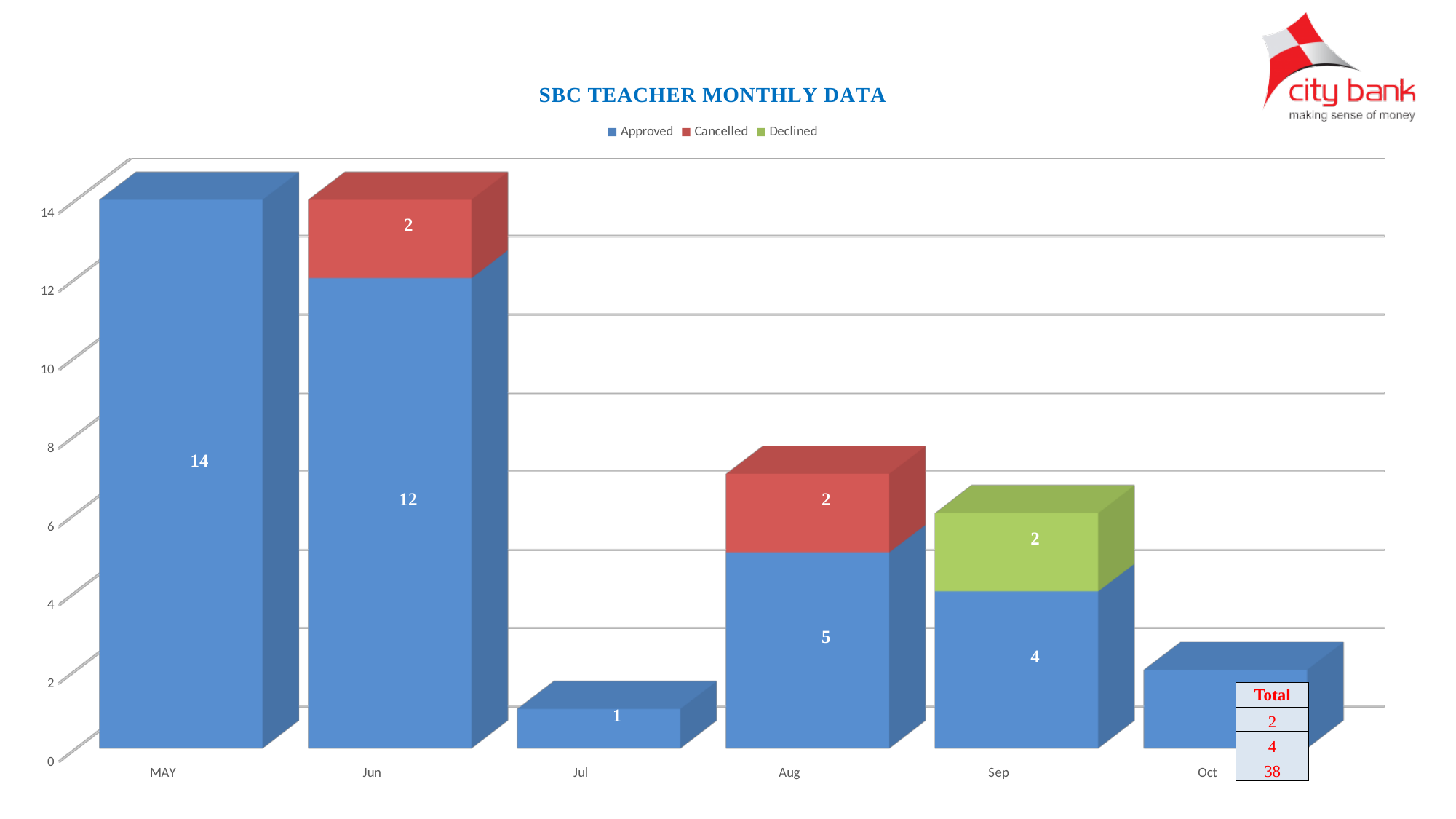
What is the Approved value for MAY? 14 What kind of chart is shown on the slide? Stacked bar chart Is the Approved value for Oct greater or less than 4? less What is the total of the stacked bar for Jun? 14 Which month has the lowest Approved value? Jul What is the total of the stacked bar for Aug? 7 Which month has the highest Approved value? MAY What is the Declined value for Sep? 2 What is the Approved value for Aug? 5 How many series does the legend list? 3 What is the difference between the Approved values for MAY and Jun? 2 What is the Cancelled value for Jun? 2